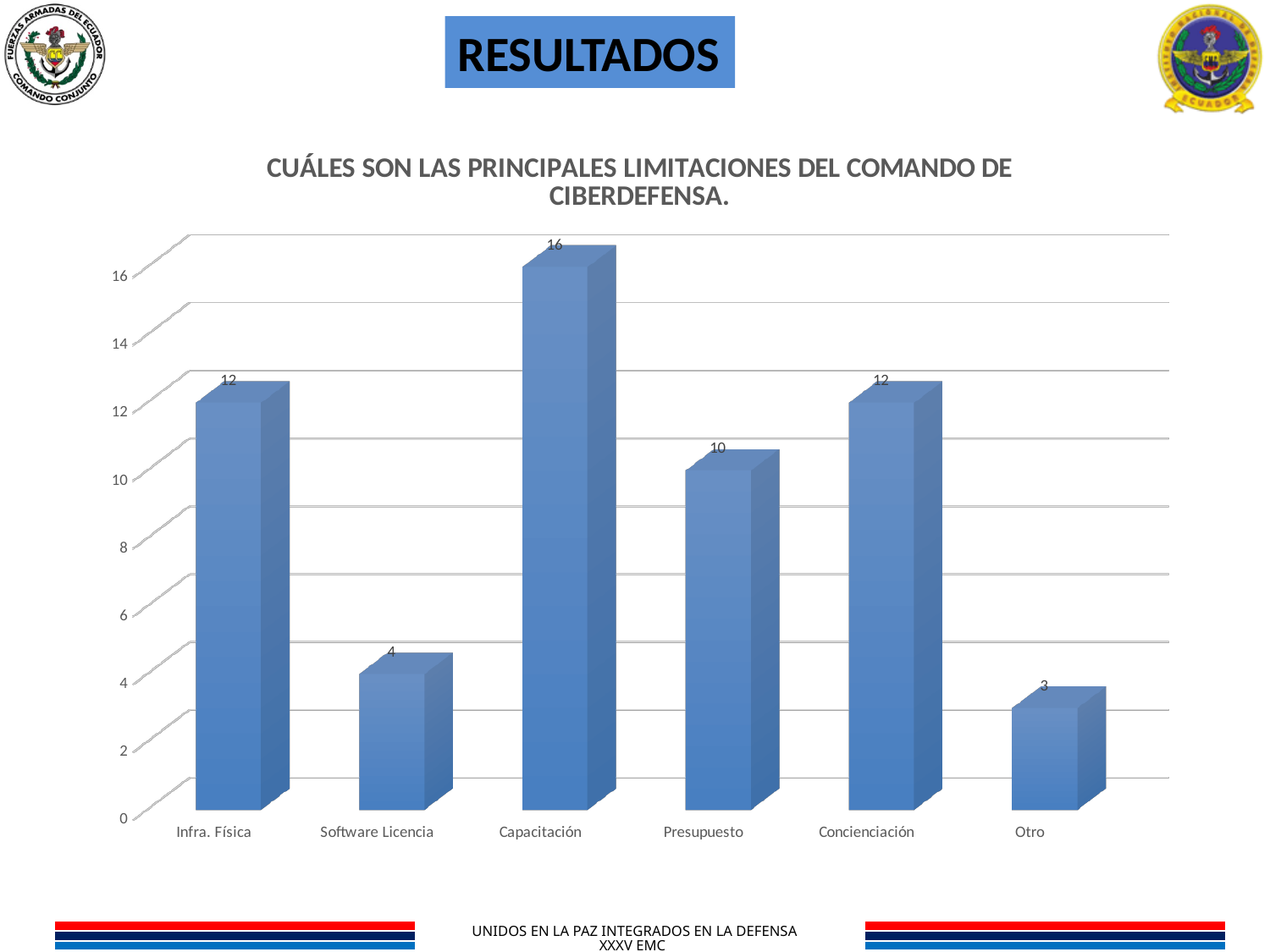
What is the difference between the values for Capacitación and Presupuesto? 6 What is the value for Presupuesto? 10 Which category has the highest value? Capacitación What is the value for Capacitación? 16 Which is larger, the value for Infra. Física or the value for Software Licencia? Infra. Física Is the value for Concienciación greater or less than 8? greater What is the value for Otro? 3 What is the title of the chart? CUÁLES SON LAS PRINCIPALES LIMITACIONES DEL COMANDO DE CIBERDEFENSA. What kind of chart is shown on the slide? bar chart How many categories are shown on the x axis? 6 Which category has the lowest value? Otro What is the value for Software Licencia? 4